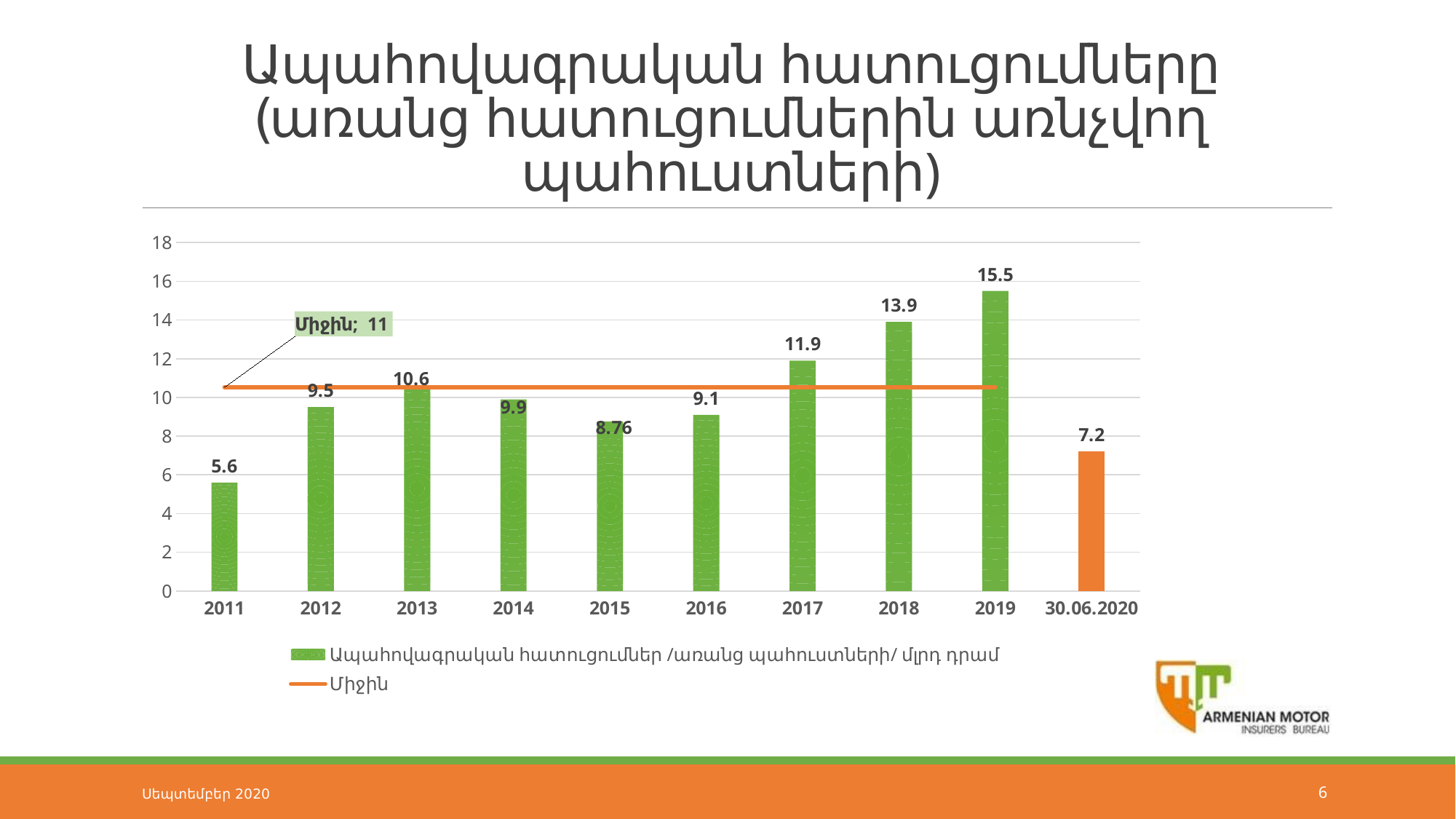
Is the value for 2017 greater or less than 10? greater Which year has the highest bar? 2019 What is the value for 2011? 5.6 Which is larger, the value for 2013 or the value for 2014? 2013 What kind of chart is shown on the slide? Combination bar and line chart How many entries does the legend list? 2 What is the value for 30.06.2020? 7.2 What is the value for 2015? 8.76 What value is shown in the label for the average (Միջին) line? 11 Which category has the lowest bar? 2011 What is the difference between the values for 2019 and 2018? 1.6 How many bars are plotted in the chart? 10